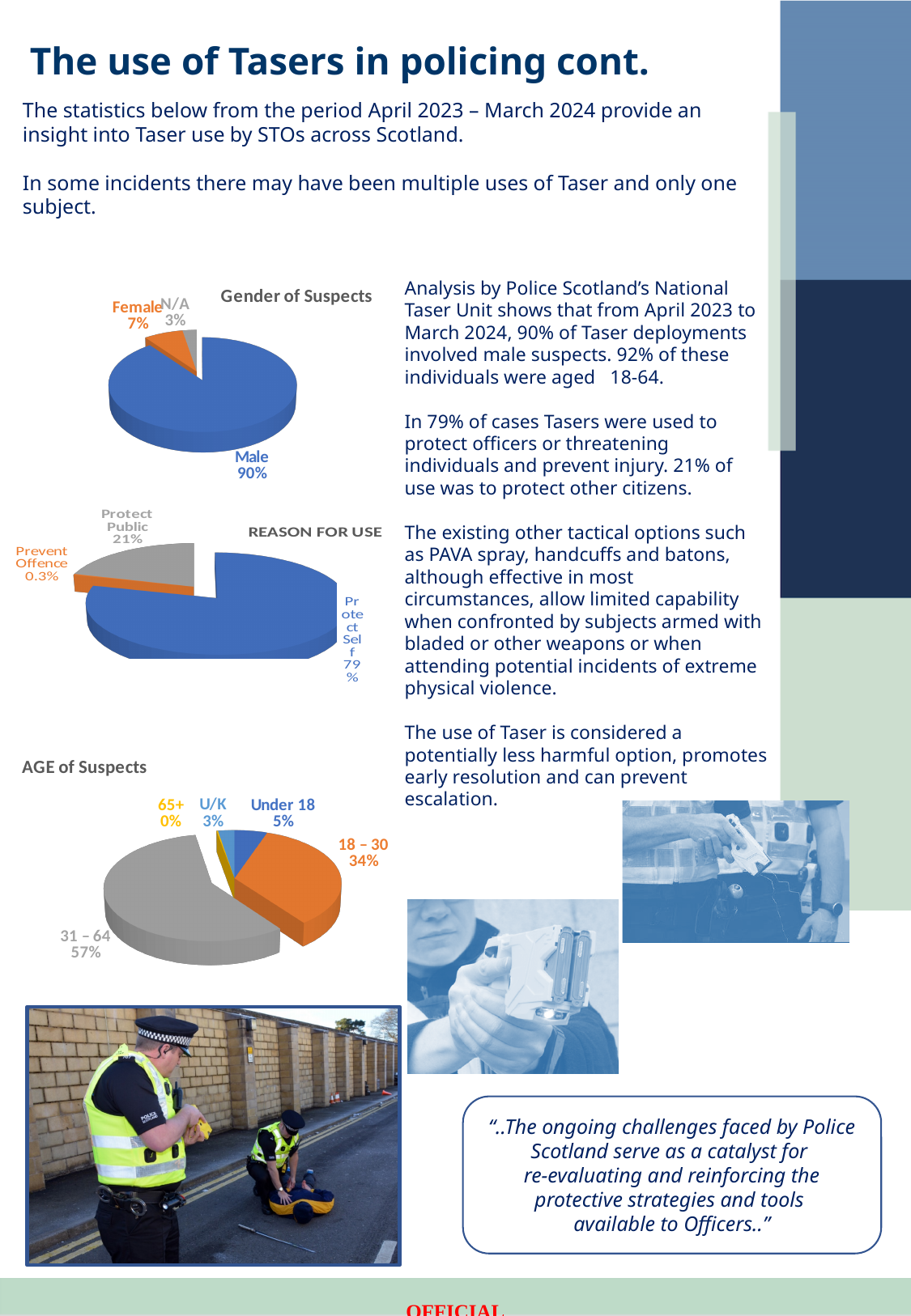
What kind of chart is the Gender of Suspects chart? Pie chart In the AGE of Suspects chart, what share of suspects were aged 31–64? 57% In the REASON FOR USE chart, what share of use was to prevent an offence? 0.3% In the AGE of Suspects chart, how many age categories are shown? 5 In the Gender of Suspects chart, what share of suspects were female? 7% In the AGE of Suspects chart, which is larger: the share for 18–30 or the share for Under 18? 18–30 In the REASON FOR USE chart, what share of use was to protect the public? 21% In the AGE of Suspects chart, which age group has the smallest share? 65+ In the REASON FOR USE chart, which reason has the largest share? Protect Self In the REASON FOR USE chart, what is the difference in percentage points between Protect Self and Protect Public? 58 In the Gender of Suspects chart, how many slices does the pie have? 3 In the Gender of Suspects chart, what share of suspects were male? 90%